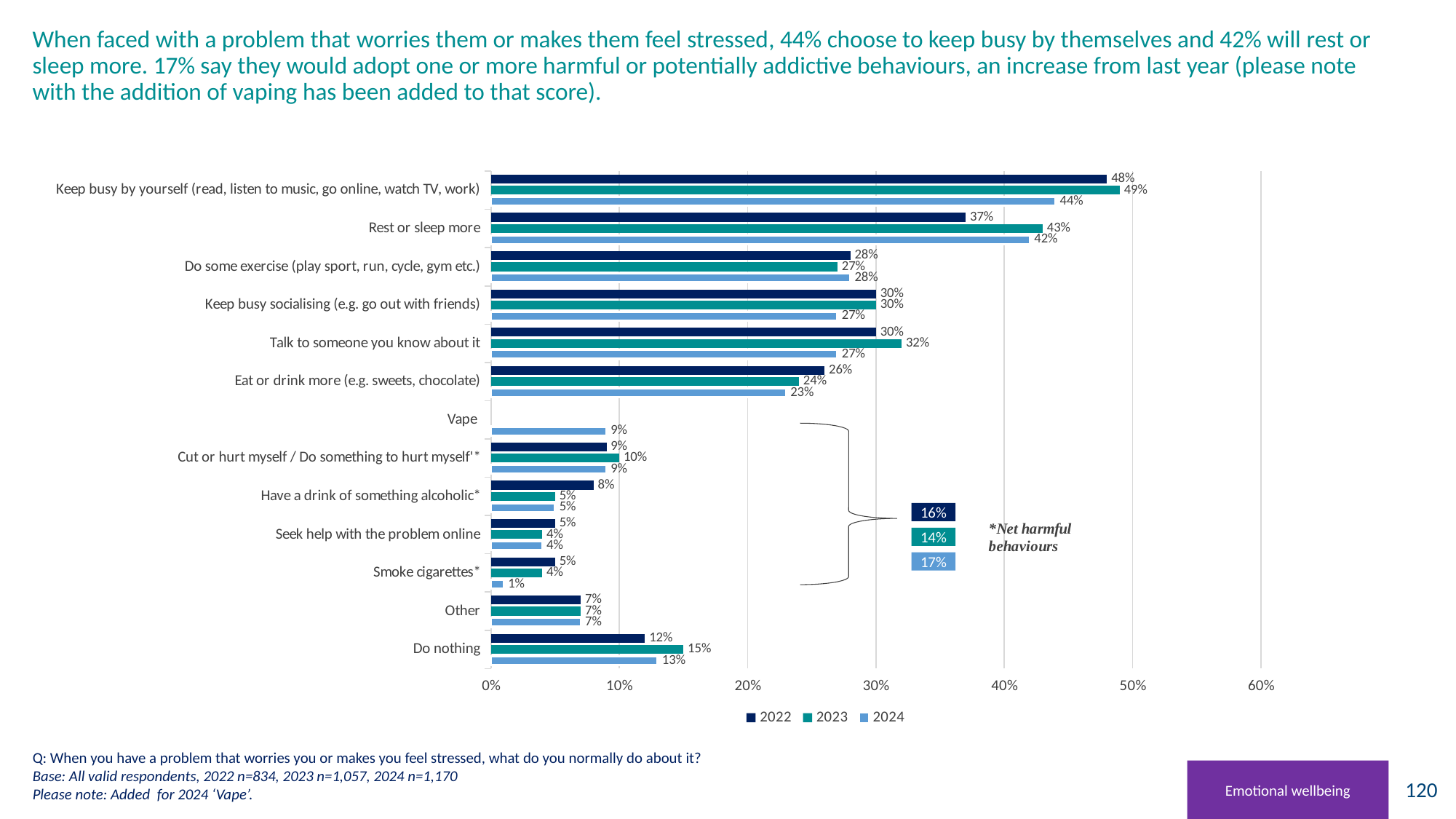
What is the 2022 value for 'Have a drink of something alcoholic*'? 8% Which category has the lowest 2024 value? Smoke cigarettes* What kind of chart is shown on the slide? Bar chart What is the 2024 value for 'Smoke cigarettes*'? 1% What is the 2023 value for 'Rest or sleep more'? 43% How many series does the legend list? 3 What is the 2024 net harmful behaviours value shown on the chart? 17% Which is larger for 'Do nothing': the 2023 value or the 2024 value? 2023 What is the difference between the 2023 and 2022 values for 'Rest or sleep more'? 6% Which category has the highest 2023 value? Keep busy by yourself (read, listen to music, go online, watch TV, work) What is the 2024 value for 'Keep busy by yourself (read, listen to music, go online, watch TV, work)'? 44% How many categories are shown on the chart? 13